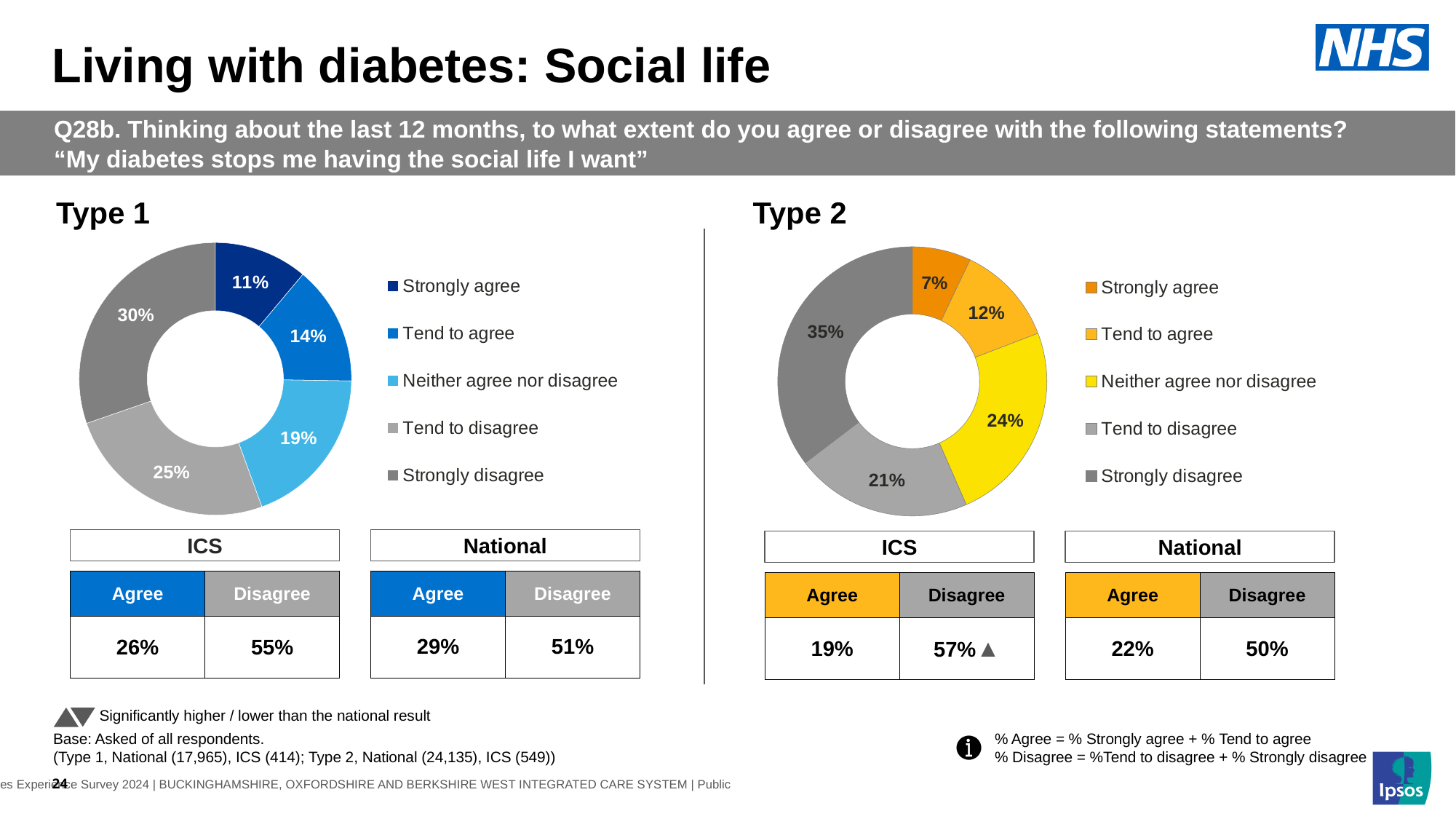
In the Type 2 chart, what percentage of respondents said 'Neither agree nor disagree'? 24% What colour represents 'Strongly agree' in the Type 2 chart? Orange In the Type 2 chart, which is larger: 'Tend to disagree' or 'Neither agree nor disagree'? Neither agree nor disagree In the Type 1 chart, what percentage of respondents said 'Strongly agree'? 11% In the Type 2 chart, what is the difference between the 'Strongly disagree' and 'Strongly agree' shares? 28 percentage points In the Type 1 chart, what percentage of respondents said 'Tend to disagree'? 25% In the Type 2 chart, what is the combined share of 'Strongly agree' and 'Tend to agree'? 19% In the Type 1 chart, which response category has the largest share? Strongly disagree In the Type 2 chart, which response category has the smallest share? Strongly agree How many response categories does the Type 1 chart show? 5 In the Type 1 chart, what is the difference between the 'Tend to disagree' and 'Tend to agree' shares? 11 percentage points What kind of chart is used for Type 2? Donut chart